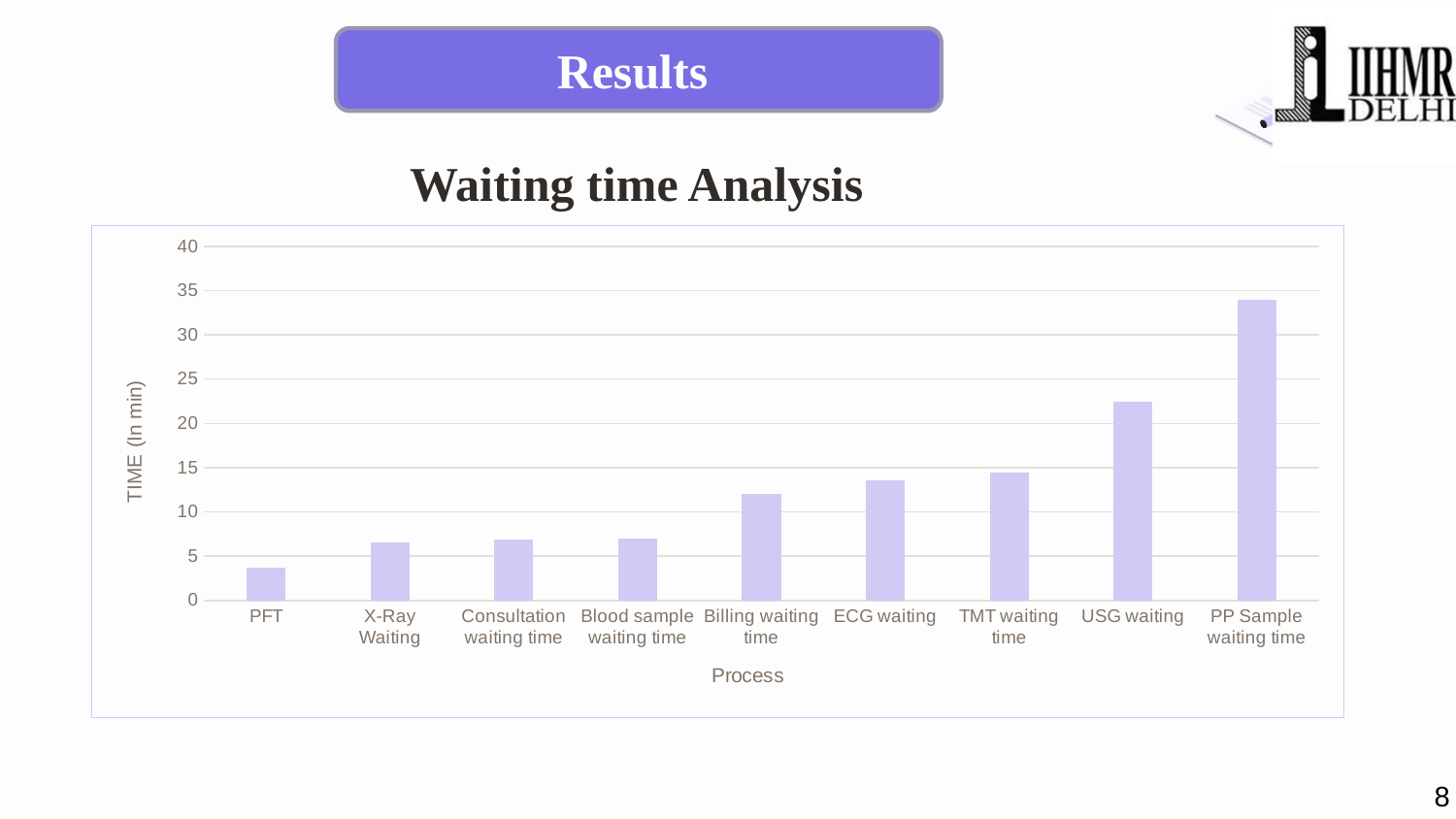
Is the value for ECG waiting greater or less than 15? less Which process has the highest waiting time? PP Sample waiting time Which has a larger waiting time, USG waiting or ECG waiting? USG waiting Is the value for PFT greater or less than 5? less Is the value for USG waiting greater or less than 20? greater What is the title of the y axis? TIME (In min) Which process has the lowest waiting time? PFT How many processes are plotted on the chart? 9 Do the waiting times rise or fall moving from left to right along the x axis? rise What kind of chart is shown on the slide? bar chart